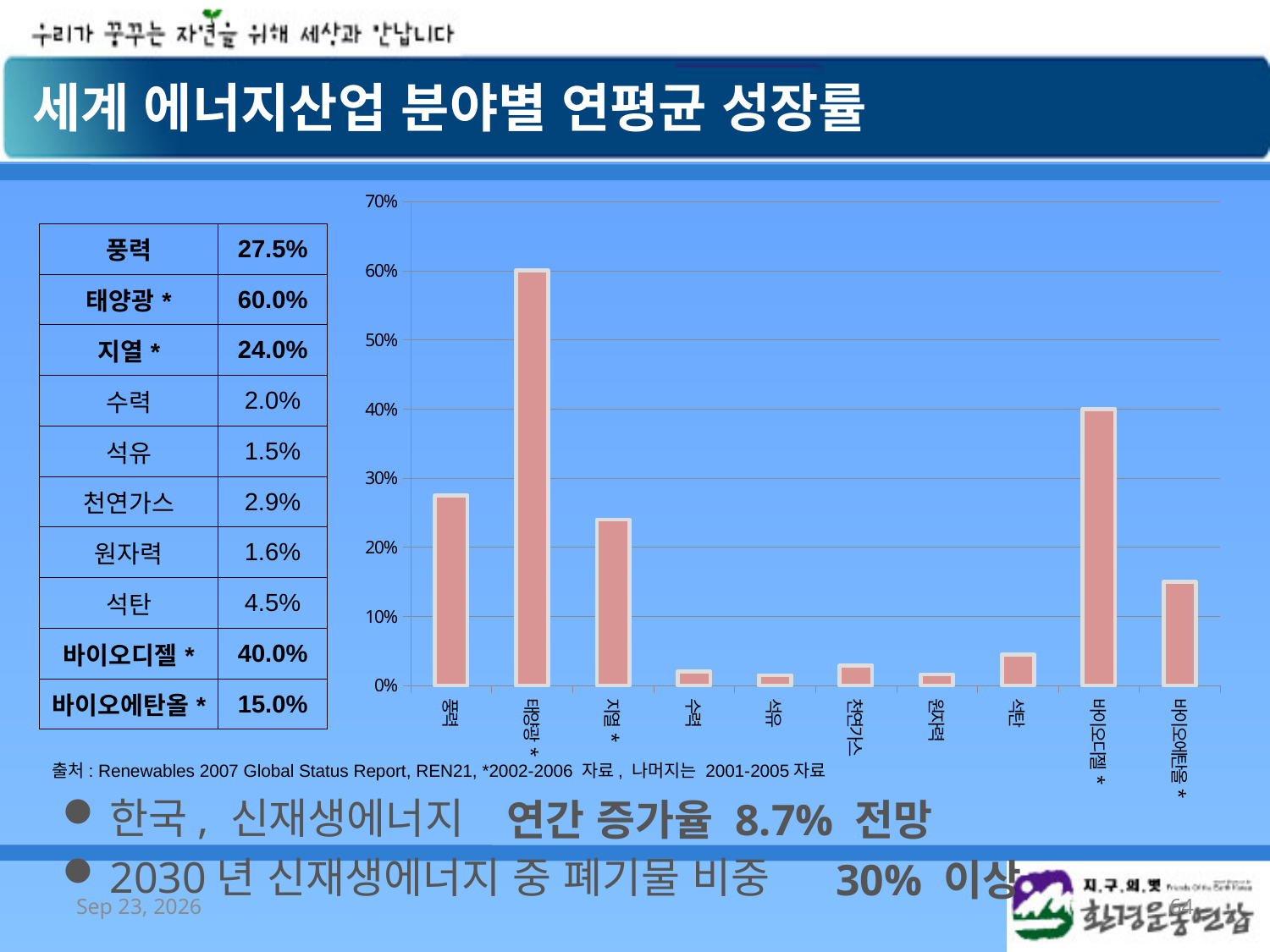
What is the title of the slide containing the chart? 세계 에너지산업 분야별 연평균 성장률 What is the average annual growth rate shown for 태양광 *? 60.0% What is the value for 석탄? 4.5% Is the value for 바이오에탄올 * greater or less than 10%? greater Which is larger, the value for 풍력 or the value for 지열 *? 풍력 What is the value for 풍력? 27.5% How many categories are plotted in the chart? 10 Which category has the highest growth rate in the chart? 태양광 * Is the value for 수력 greater or less than 10%? less What is the difference between the values for 태양광 * and 바이오디젤 *? 20.0% What value is shown for 바이오디젤 *? 40.0% What kind of chart is shown on the slide? bar chart